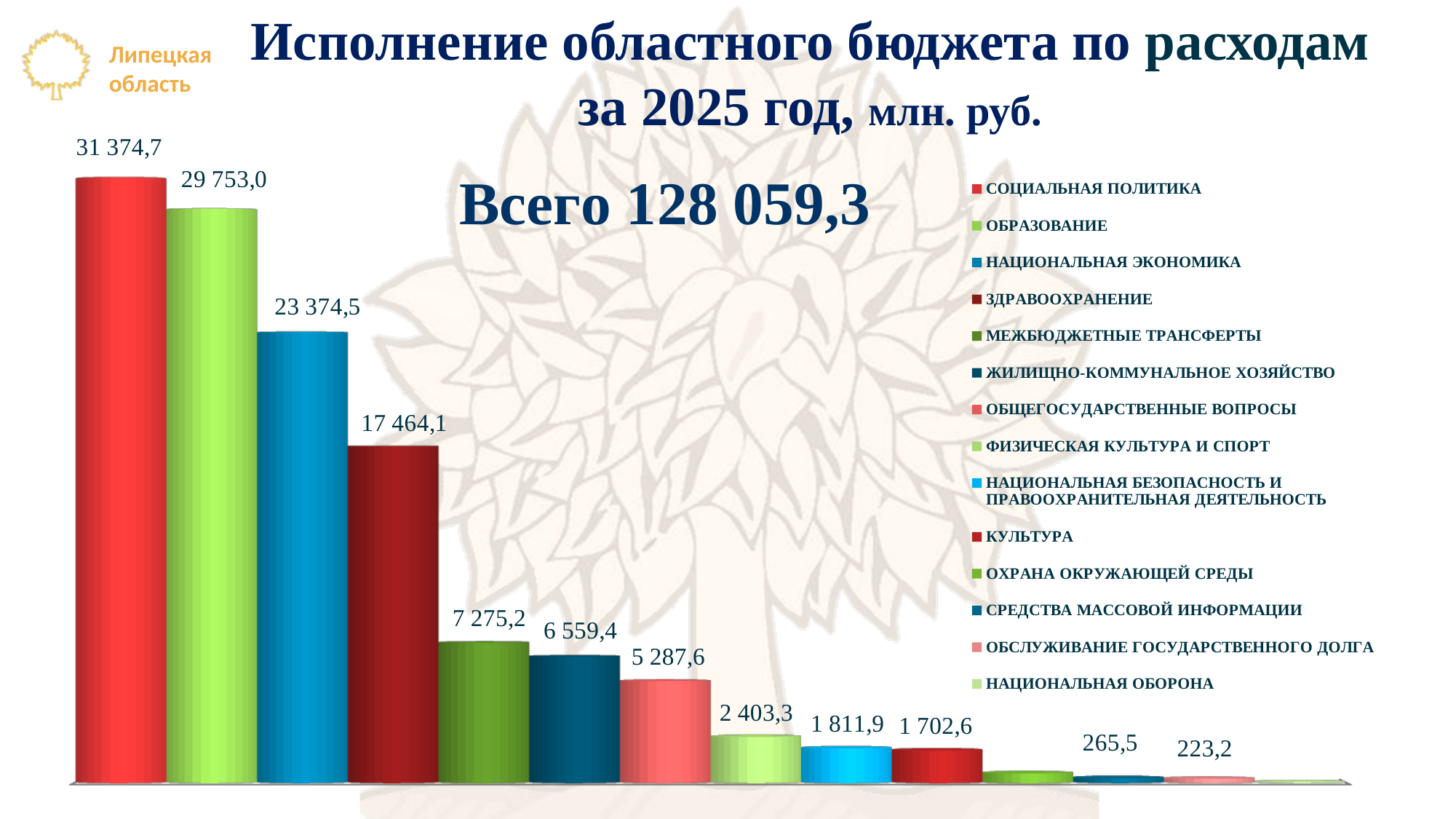
Which category has the highest value? СОЦИАЛЬНАЯ ПОЛИТИКА What is the difference between the values for МЕЖБЮДЖЕТНЫЕ ТРАНСФЕРТЫ and ЖИЛИЩНО-КОММУНАЛЬНОЕ ХОЗЯЙСТВО? 715,8 What kind of chart is shown on the slide? Bar chart What is the value for СОЦИАЛЬНАЯ ПОЛИТИКА? 31 374,7 What is the value for КУЛЬТУРА? 1 702,6 Which is larger, the value for НАЦИОНАЛЬНАЯ ЭКОНОМИКА or the value for ЗДРАВООХРАНЕНИЕ? НАЦИОНАЛЬНАЯ ЭКОНОМИКА How many entries does the legend list? 14 What total value is stated on the slide? 128 059,3 What is the value for ЗДРАВООХРАНЕНИЕ? 17 464,1 What is the difference between the values for СОЦИАЛЬНАЯ ПОЛИТИКА and ОБРАЗОВАНИЕ? 1 621,7 What is the value for ОБЩЕГОСУДАРСТВЕННЫЕ ВОПРОСЫ? 5 287,6 How many bars are plotted in the chart? 14